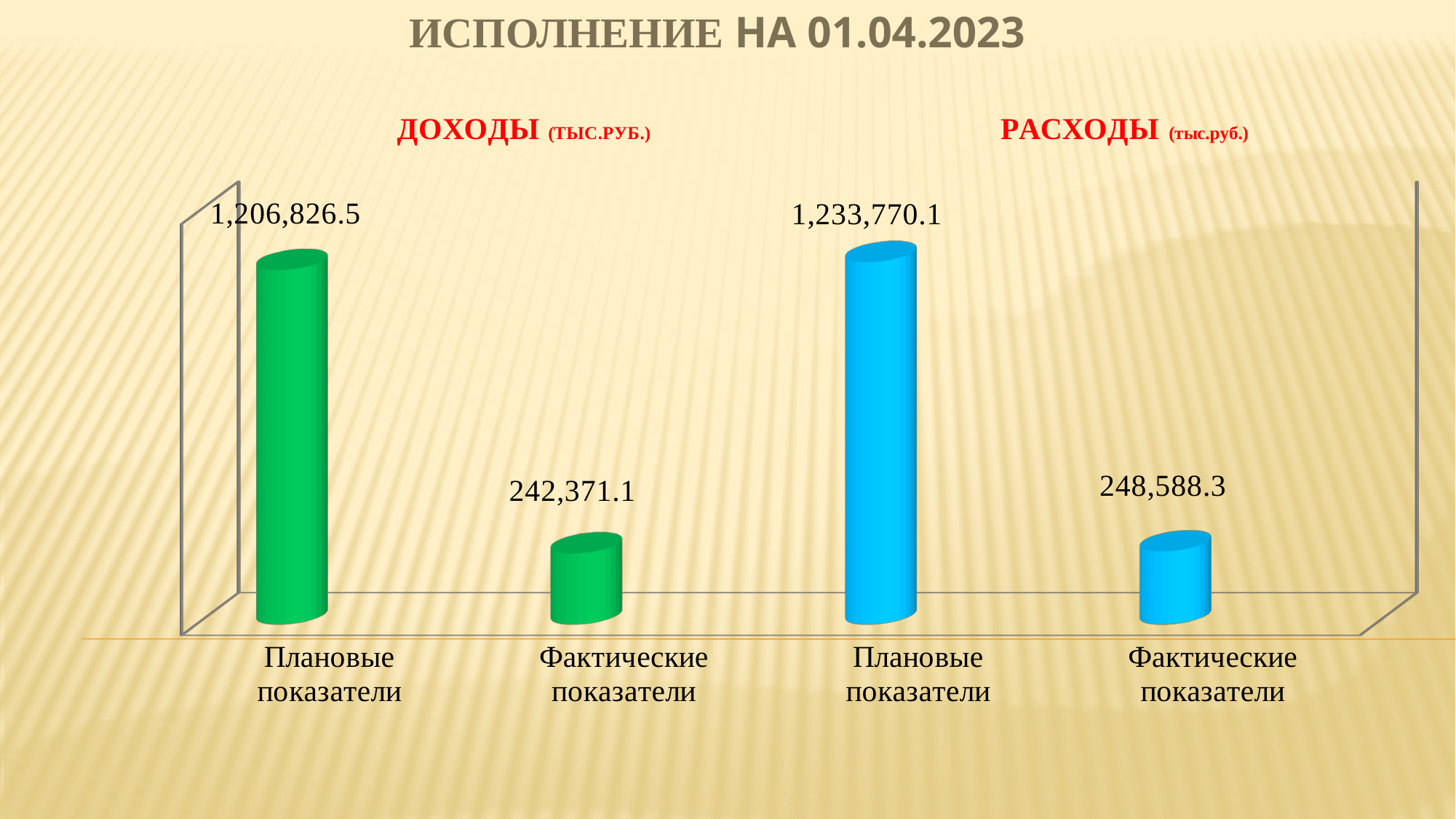
What colour are the bars for РАСХОДЫ? Blue How many bars are plotted on the chart? 4 Which bar has the lowest value on the chart? Фактические показатели (ДОХОДЫ) What is the value of the planned indicators (Плановые показатели) for РАСХОДЫ? 1,233,770.1 What kind of chart is shown on the slide? Bar chart Which bar has the highest value on the chart? Плановые показатели (РАСХОДЫ) What is the difference between the planned and actual indicators for ДОХОДЫ? 964,455.4 What is the difference between the planned and actual indicators for РАСХОДЫ? 985,181.8 What is the value of the planned indicators (Плановые показатели) for ДОХОДЫ? 1,206,826.5 What is the value of the actual indicators (Фактические показатели) for ДОХОДЫ? 242,371.1 What is the value of the actual indicators (Фактические показатели) for РАСХОДЫ? 248,588.3 Which is larger: the planned indicators for ДОХОДЫ or the planned indicators for РАСХОДЫ? Планoвые показатели for РАСХОДЫ